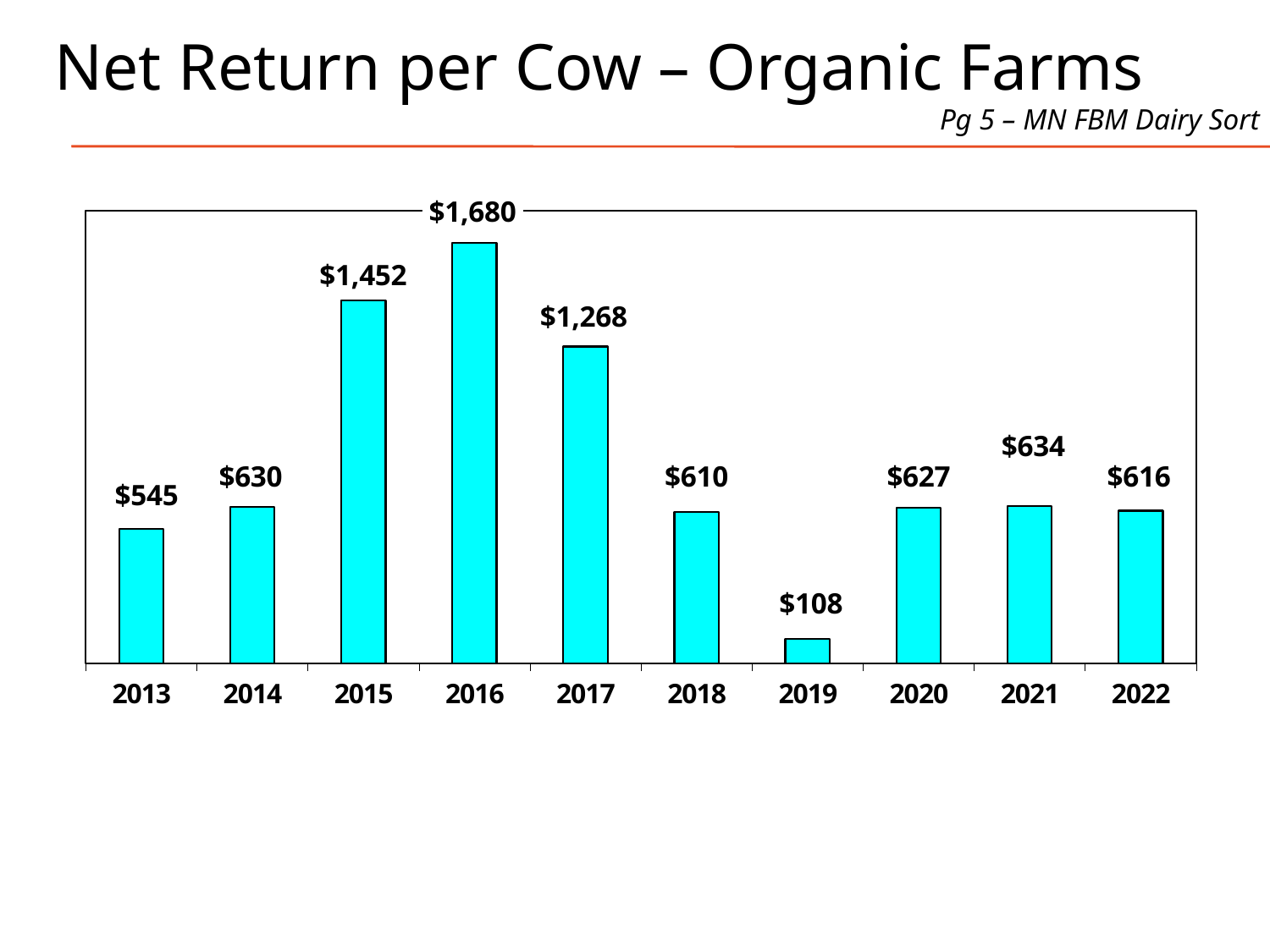
What is the net return per cow for 2016? $1,680 What is the net return per cow for 2019? $108 Which year has the lowest net return per cow? 2019 What kind of chart is shown on the slide? Bar chart What is the difference between the net return per cow in 2016 and in 2015? $228 What is the net return per cow for 2022? $616 Did the net return per cow rise or fall from 2016 to 2019? Fall Which year has a larger net return per cow, 2014 or 2018? 2014 What is the difference between the net return per cow in 2021 and in 2019? $526 Which year has a larger net return per cow, 2017 or 2020? 2017 How many years are shown on the chart? 10 Which year has the highest net return per cow? 2016